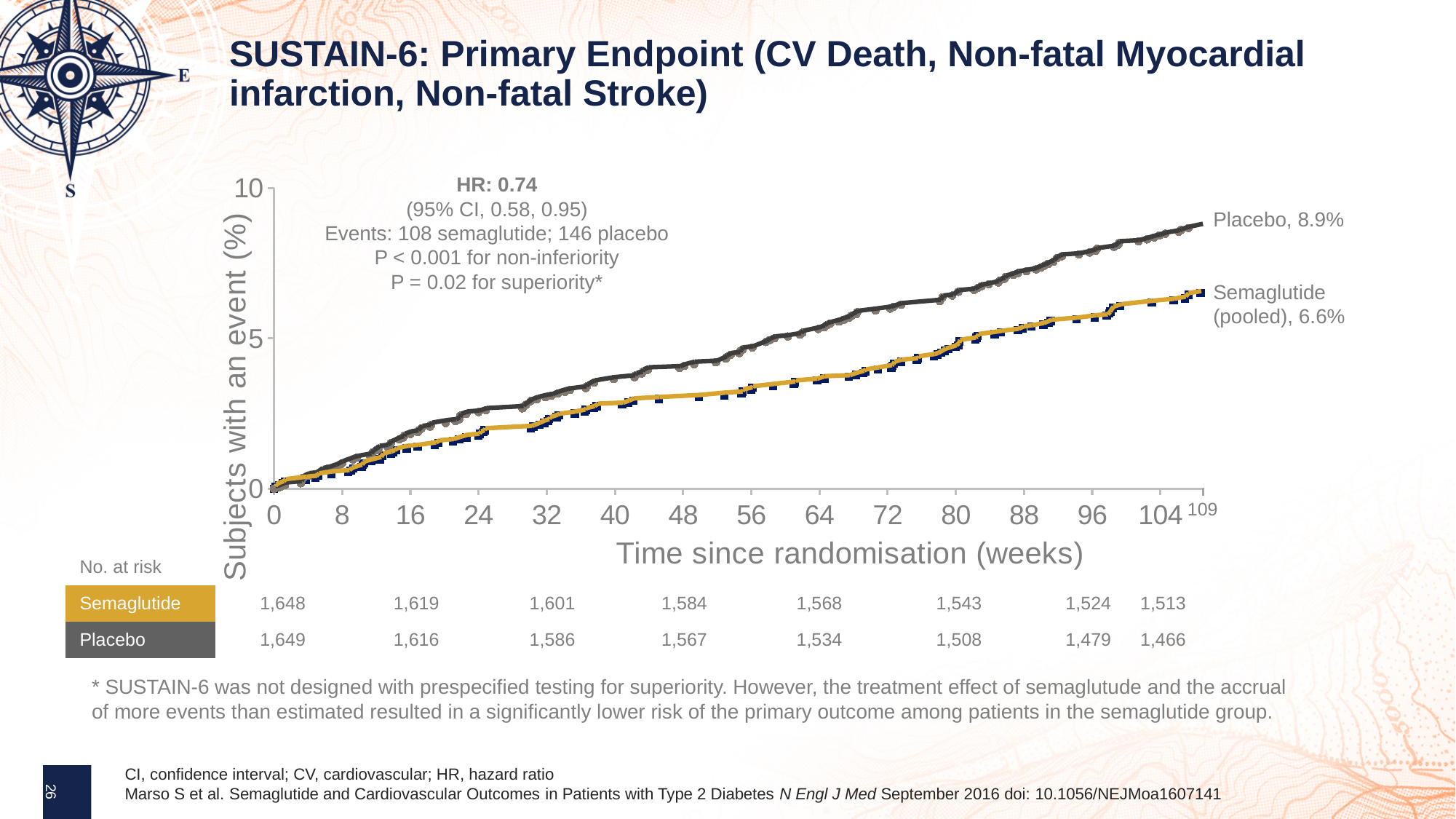
What is the label of the x axis? Time since randomisation (weeks) Is the Placebo curve at week 72 greater or less than 5%? greater How many Placebo subjects were at risk at the last time point in the No. at risk table? 1,466 What is the final percentage of subjects with an event in the Placebo group? 8.9% How many Semaglutide subjects were at risk at week 0 according to the No. at risk table? 1,648 What is the difference between the final Placebo and Semaglutide (pooled) event percentages? 2.3 percentage points Is the Semaglutide (pooled) curve at week 72 greater or less than 5%? less Do the curves rise or fall as time since randomisation increases? rise What is the final percentage of subjects with an event in the Semaglutide (pooled) group? 6.6% What kind of chart is shown on the slide? line chart How many treatment groups are plotted on the chart? 2 Which group has the higher percentage of subjects with an event at the end of follow-up, Placebo or Semaglutide (pooled)? Placebo